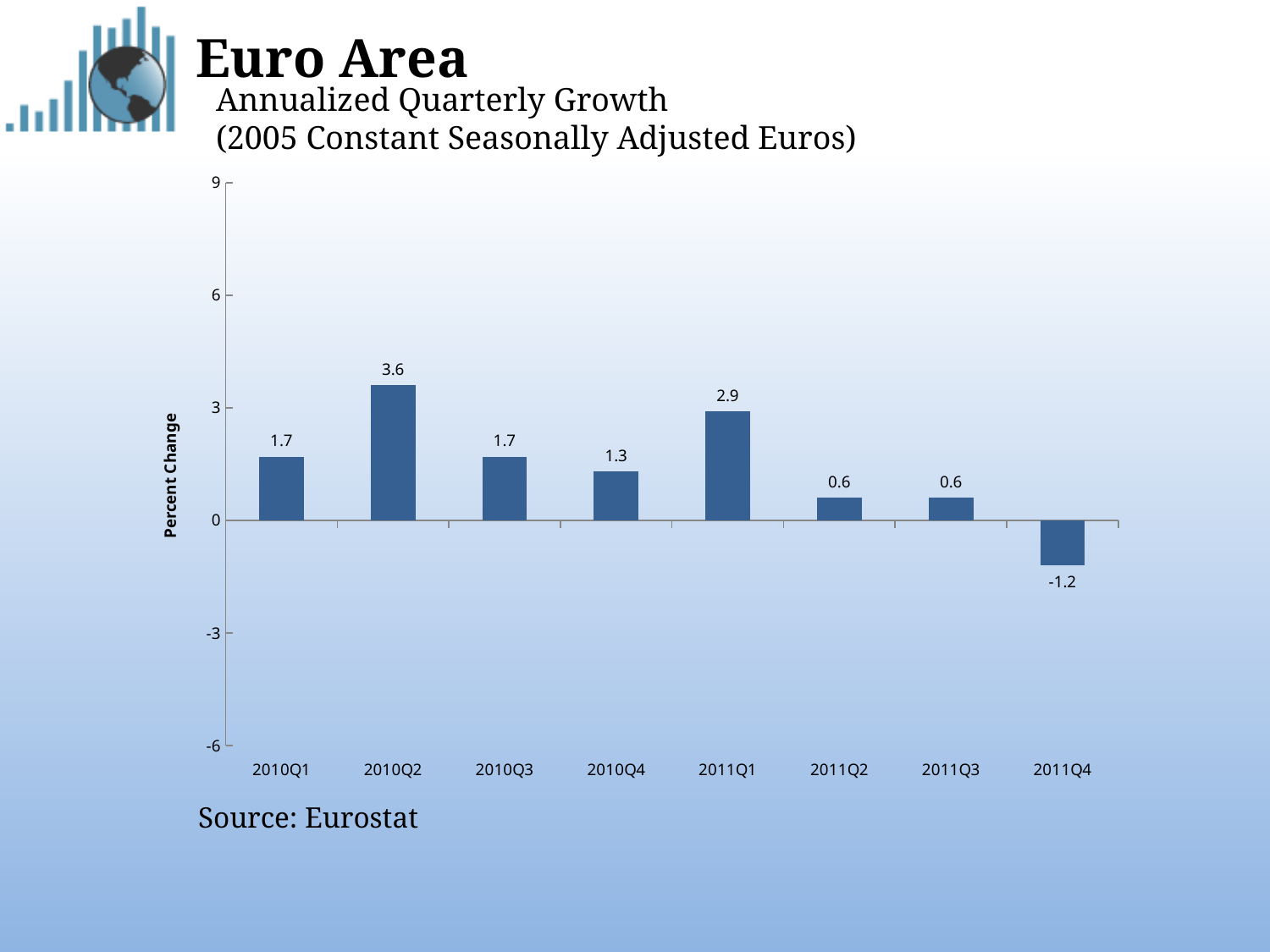
What is the value shown for 2011Q4? -1.2 Do the values generally rise or fall from 2011Q1 to 2011Q4? fall Which quarter has the highest annualized growth? 2010Q2 What is the annualized quarterly growth value for 2010Q2? 3.6 How many quarters are shown on the x axis? 8 What is the label on the vertical axis? Percent Change What is the difference between the values for 2010Q2 and 2011Q1? 0.7 Which quarter has the lowest annualized growth? 2011Q4 Which is larger, the value for 2010Q4 or the value for 2011Q2? 2010Q4 Is the value for 2010Q2 greater or less than 3? greater What kind of chart is shown on the slide? bar chart What is the value shown for 2011Q1? 2.9